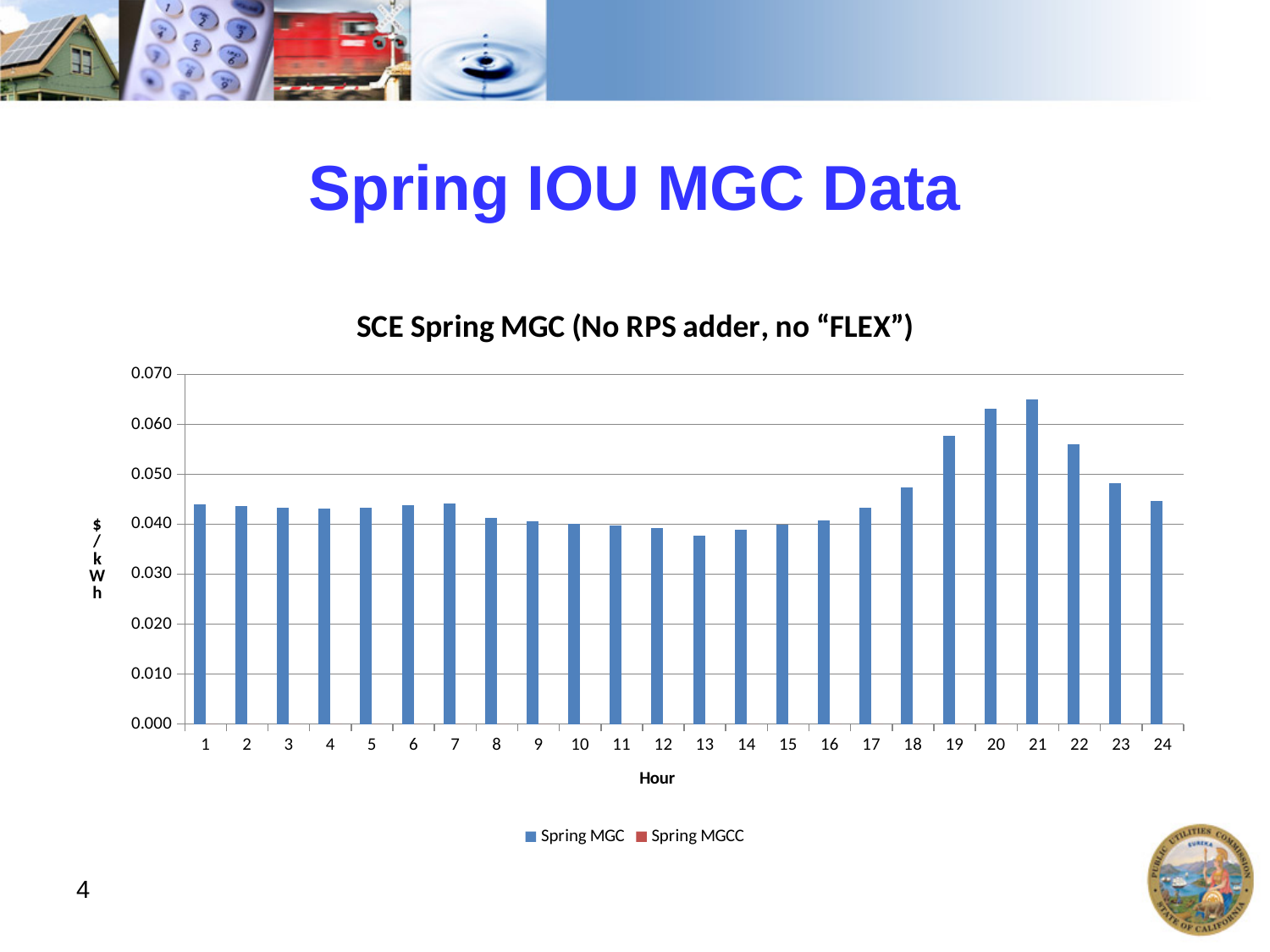
Do the Spring MGC values rise or fall from hour 13 to hour 21? rise How many series does the chart legend list? 2 Which hour has the highest Spring MGC value? 21 Which hour has the lowest Spring MGC value? 13 What is the label on the x axis of the chart? Hour What kind of chart is shown on the slide? bar chart Is the Spring MGC value for hour 13 greater or less than 0.040? less What is the title of the chart? SCE Spring MGC (No RPS adder, no "FLEX") Which hour has the larger Spring MGC value, hour 20 or hour 22? 20 Is the Spring MGC value for hour 19 greater or less than 0.050? greater How many hours (categories) are plotted along the x axis? 24 Is the Spring MGC value for hour 21 greater or less than 0.060? greater